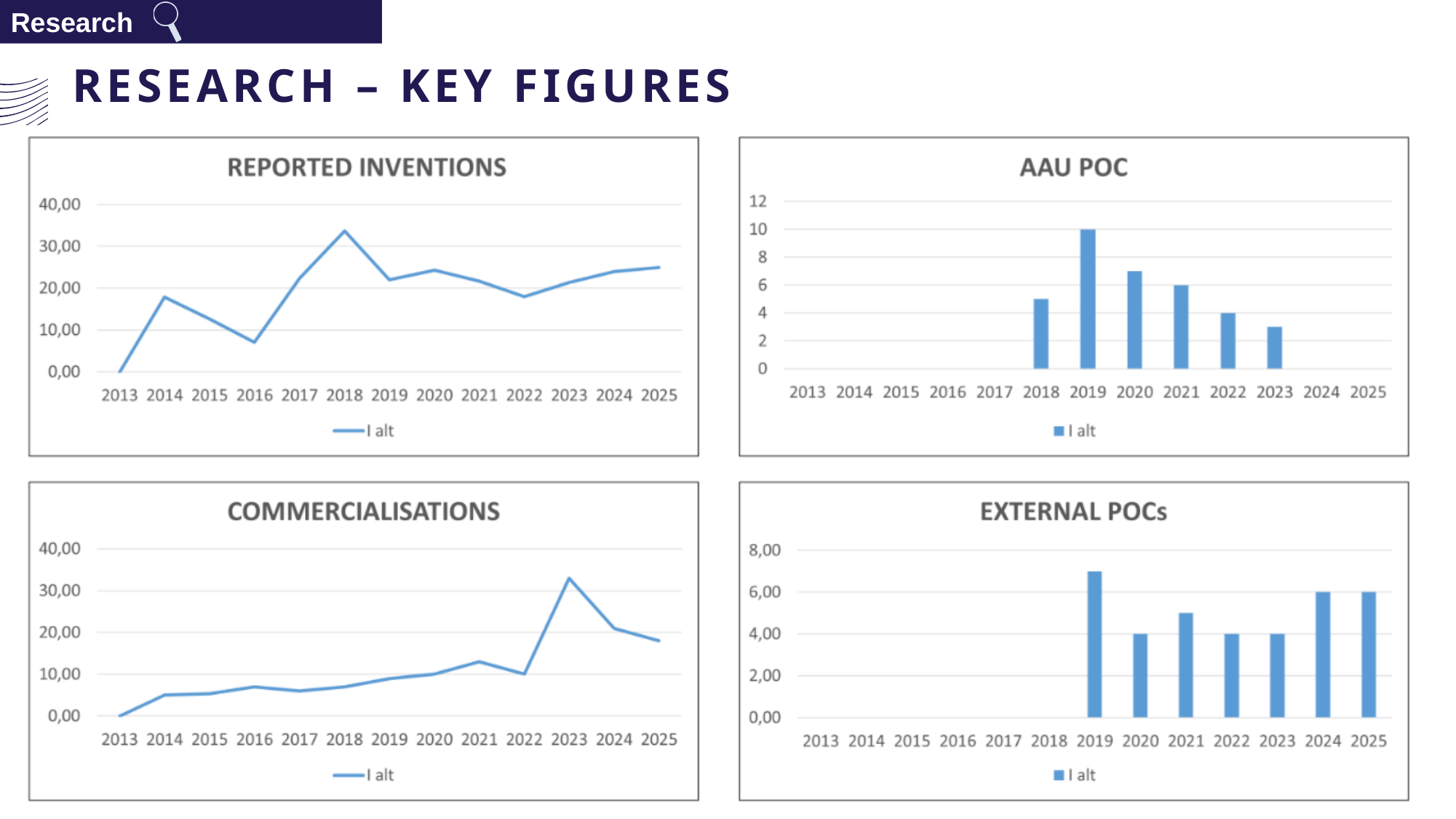
In the COMMERCIALISATIONS chart, which year has the highest value? 2023 In the REPORTED INVENTIONS chart, which year has the highest value? 2018 In the EXTERNAL POCs chart, is the value for 2019 greater or less than 6,00? greater In the AAU POC chart, which year has the highest value? 2019 What type of chart is the AAU POC chart? bar chart In the AAU POC chart, what is the value for 2022? 4 In the COMMERCIALISATIONS chart, is the value for 2023 greater or less than 30,00? greater In the AAU POC chart, is the value for 2021 larger than the value for 2023? yes In the AAU POC chart, what is the value for 2019? 10 What type of chart is the REPORTED INVENTIONS chart? line chart In the EXTERNAL POCs chart, what is the value for 2024? 6,00